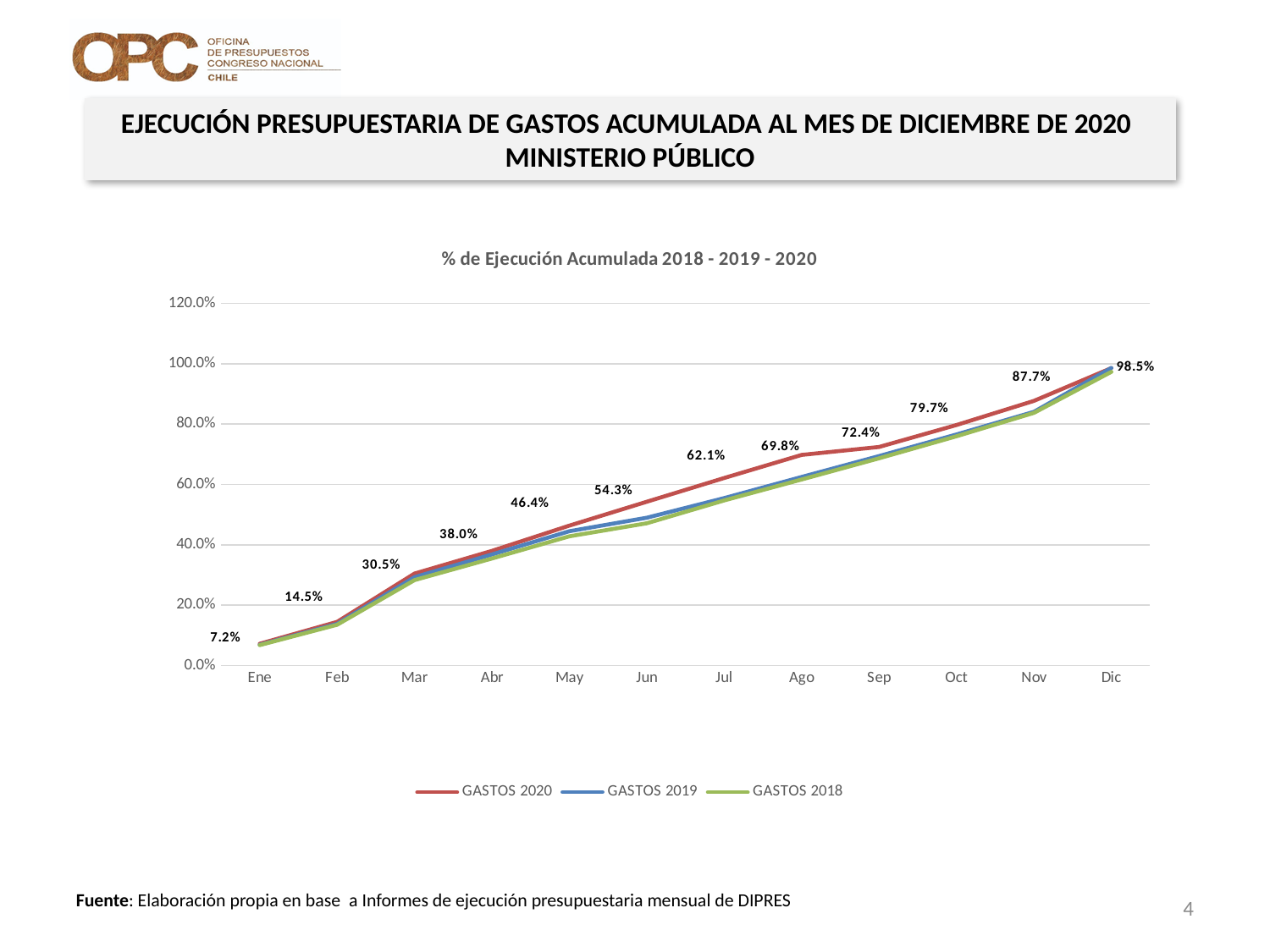
In which month is the GASTOS 2020 value lowest? Ene What is the labelled value for GASTOS 2020 in Dic? 98.5% How many months are plotted along the x axis? 12 What kind of chart is shown on the slide? line chart How many series does the legend list? 3 What is the labelled value for GASTOS 2020 in Ene? 7.2% Is the value for GASTOS 2018 in Jun greater or less than 60.0%? less Do the GASTOS 2020 values rise or fall from Ene to Dic? rise In which month is the GASTOS 2020 value highest? Dic What is the labelled value for GASTOS 2020 in Jun? 54.3% What is the difference between the GASTOS 2020 values for Dic (98.5%) and Nov (87.7%)? 10.8 percentage points Which is larger for GASTOS 2020, the value in Ago or the value in Sep? Sep